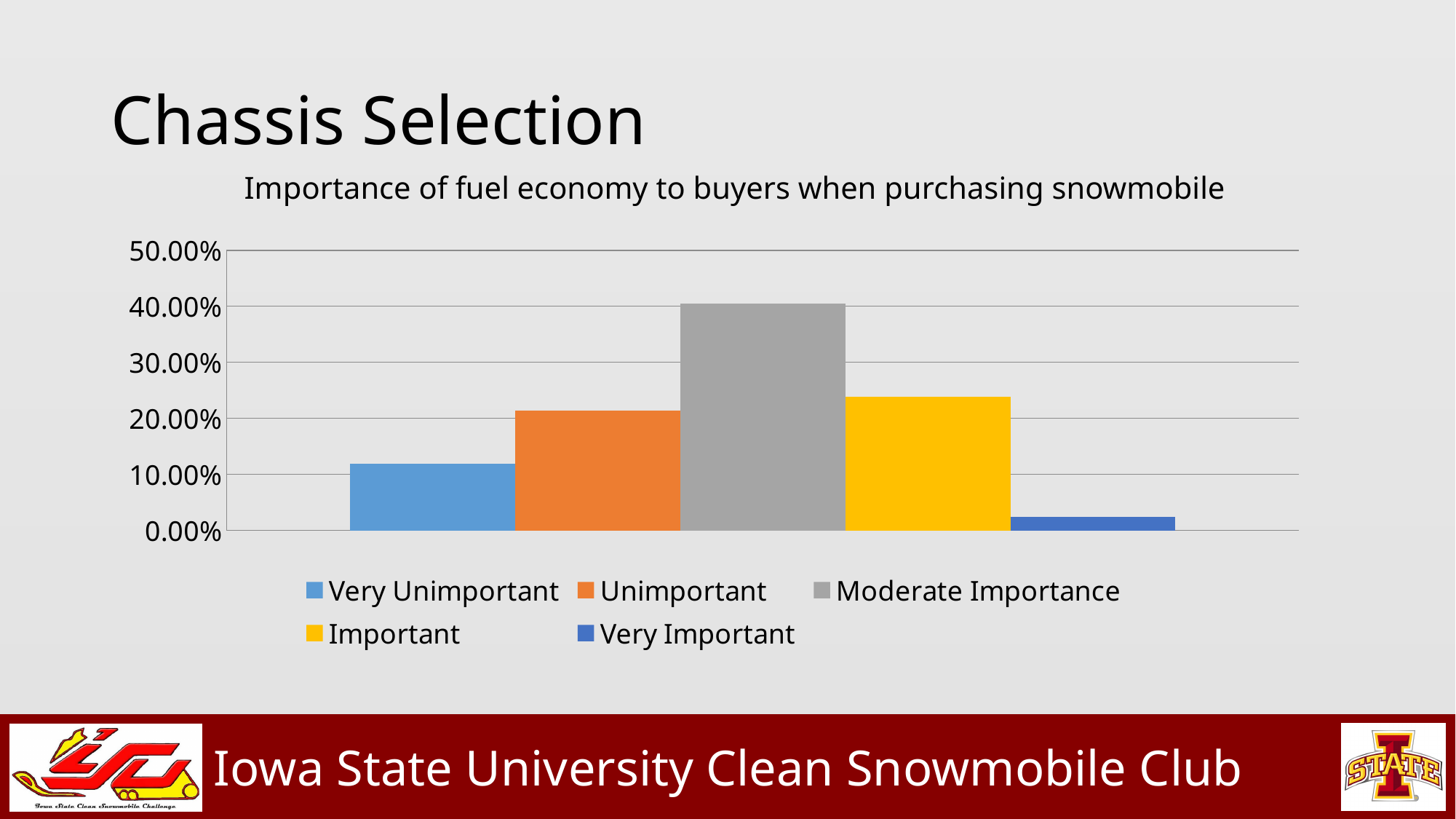
Which is larger, the value for Moderate Importance or the value for Important? Moderate Importance Is the value for Unimportant greater or less than 20.00%? greater How many series does the legend list? 5 Which colour is used for the Moderate Importance bar? grey Which category has the lowest value? Very Important What kind of chart is shown on the slide? bar chart What is the title of the chart? Importance of fuel economy to buyers when purchasing snowmobile Is the value for Very Important greater or less than 10.00%? less Is the value for Very Unimportant greater or less than 10.00%? greater Which category has the highest value? Moderate Importance